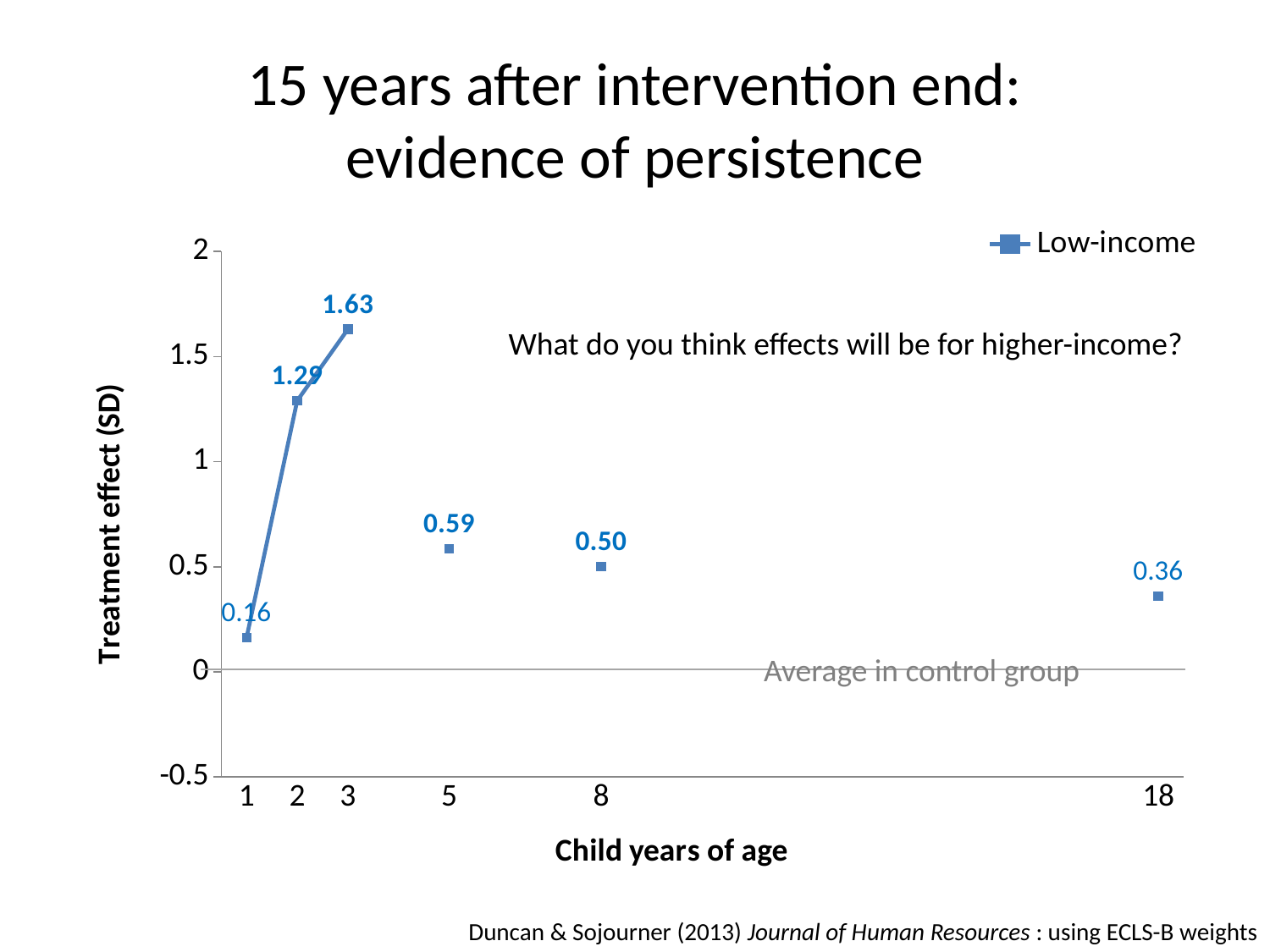
What is the label of the y axis? Treatment effect (SD) Which is larger, the treatment effect at age 5 or at age 18? age 5 Is the treatment effect at age 2 greater or less than 1? greater What is the treatment effect for low-income children at age 18? 0.36 What is the treatment effect for low-income children at age 1? 0.16 At which child age is the treatment effect highest? 3 What is the treatment effect for low-income children at age 3? 1.63 At which child age is the treatment effect lowest? 1 What is the difference between the treatment effect at age 5 and at age 8? 0.09 What is the difference between the treatment effect at age 3 and at age 2? 0.34 How many data points are plotted on the chart? 6 How many series does the legend list? 1